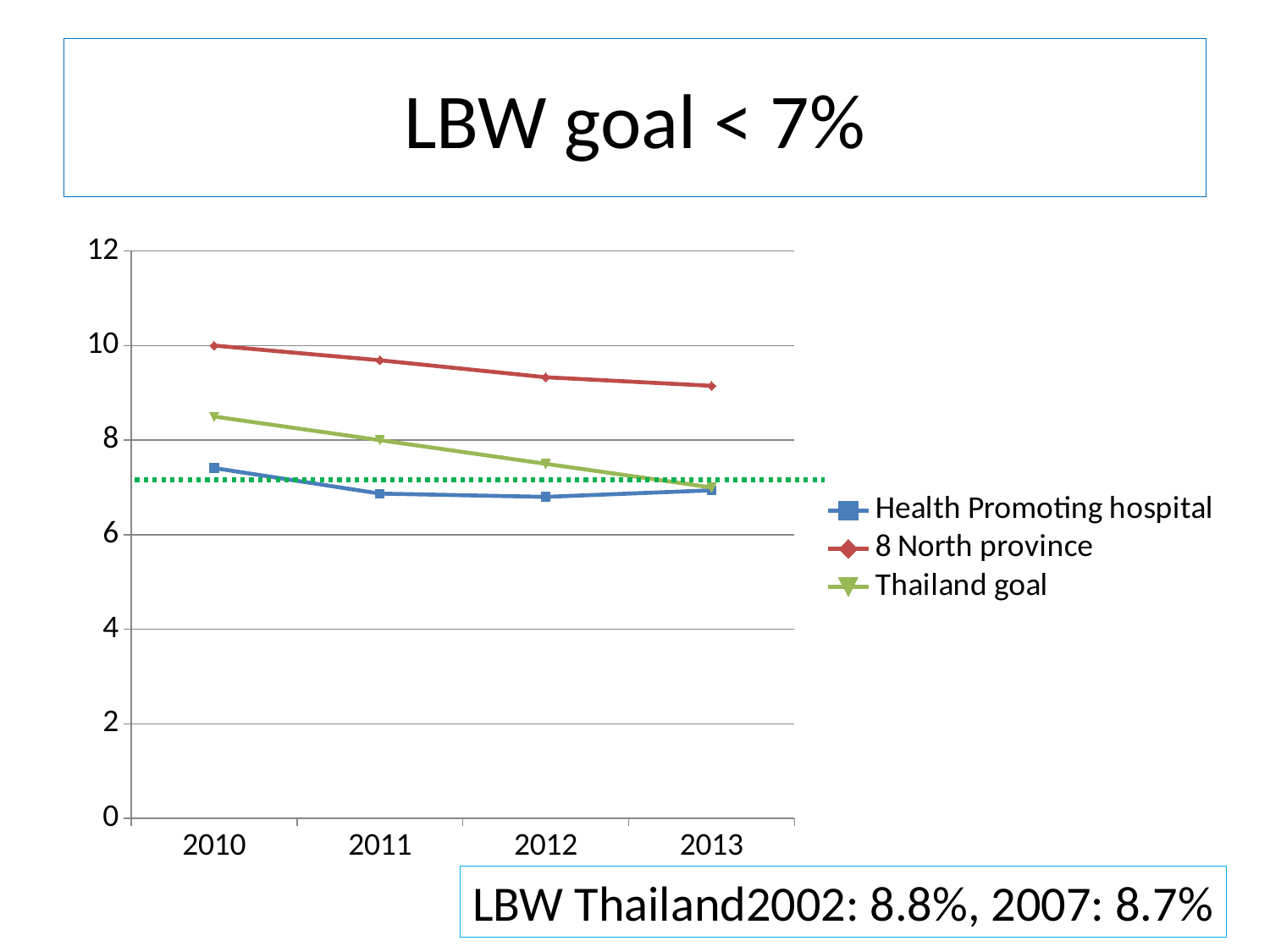
What kind of chart is shown on the slide? line chart Which series has the lowest value in 2012? Health Promoting hospital How many series does the legend list? 3 How many years are shown on the x axis? 4 Is the value for Health Promoting hospital in 2011 greater or less than 8? less Which series has the highest value in 2010? 8 North province Is the value for Thailand goal in 2010 greater or less than 8? greater Which series is drawn in red on the chart? 8 North province Does the 8 North province line rise or fall from 2010 to 2013? fall What is the title of the slide above the chart? LBW goal < 7% In 2012, which is higher: Thailand goal or Health Promoting hospital? Thailand goal Is the value for 8 North province in 2013 greater or less than 8? greater